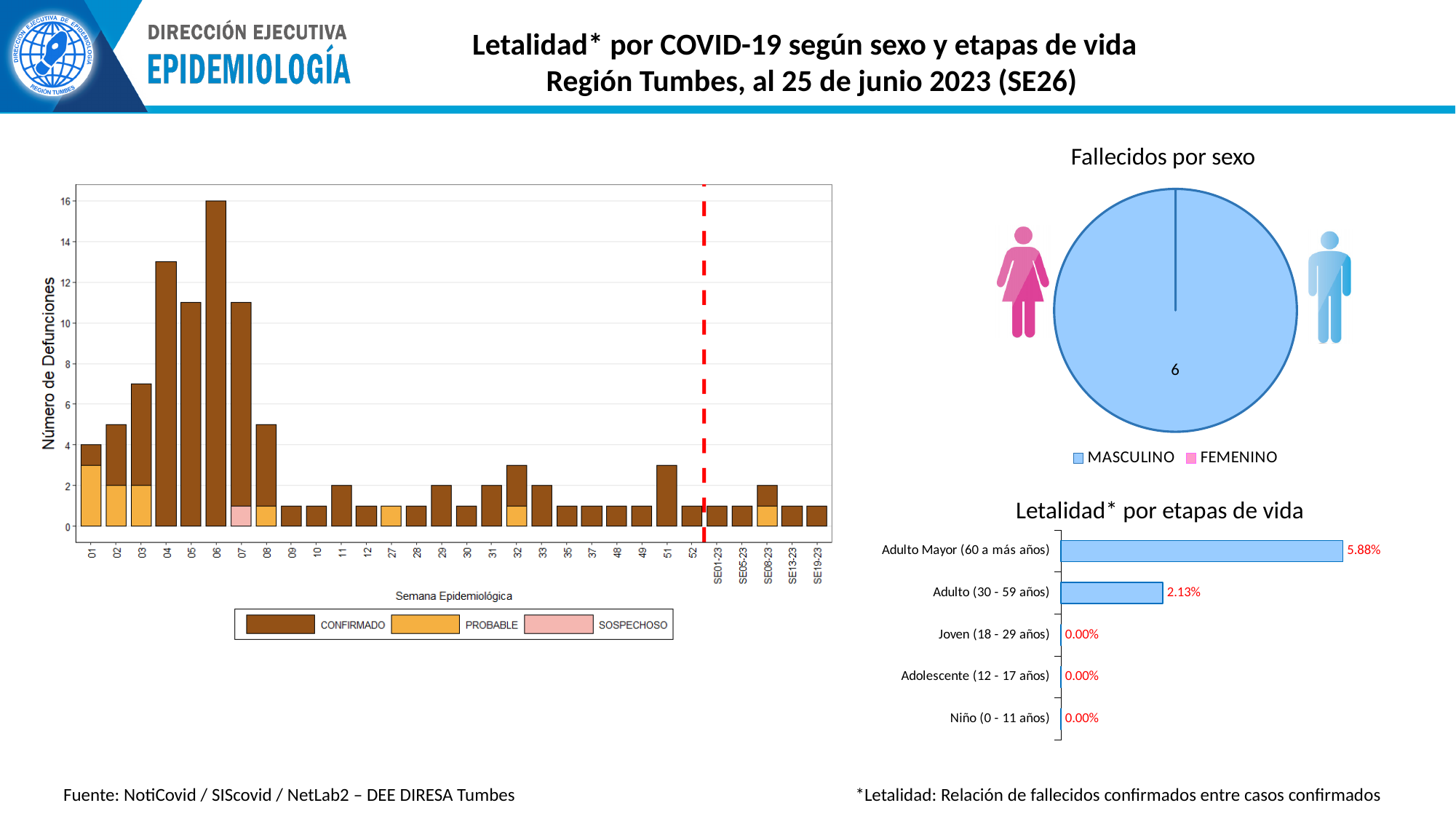
On the 'Fallecidos por sexo' chart, what value is shown for MASCULINO? 6 On the 'Letalidad* por etapas de vida' chart, which age group has the highest lethality? Adulto Mayor (60 a más años) On the weekly deaths chart on the left, what is the total number of deaths in week 06? 16 On the 'Letalidad* por etapas de vida' chart, how many age groups are shown? 5 On the 'Letalidad* por etapas de vida' chart, what is the value for Adulto Mayor (60 a más años)? 5.88% What kind of chart is 'Fallecidos por sexo'? Pie chart On the weekly deaths chart on the left, is the value for week 04 greater or less than 12? greater On the 'Fallecidos por sexo' chart, how many categories does the legend list? 2 On the 'Letalidad* por etapas de vida' chart, what is the difference between the values for Adulto Mayor (60 a más años) and Adulto (30 - 59 años)? 3.75% On the weekly deaths chart on the left, how many series does the legend list? 3 On the weekly deaths chart on the left, which epidemiological week has the highest number of deaths? 06 On the 'Letalidad* por etapas de vida' chart, what is the value for Adulto (30 - 59 años)? 2.13%